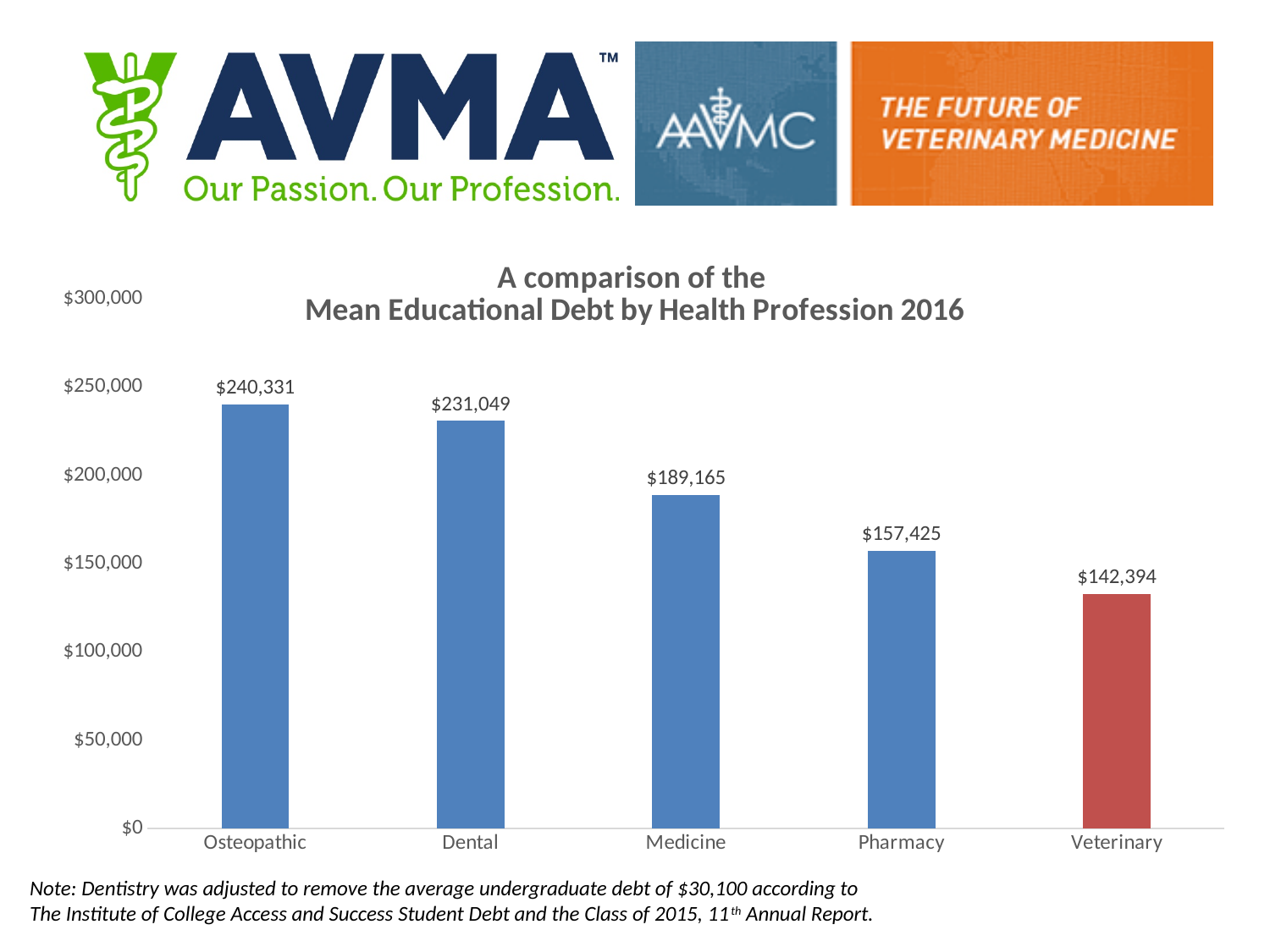
What is the difference in mean educational debt between Dental and Medicine? $41,884 Which bar in the chart is coloured red rather than blue? Veterinary Which has a higher mean educational debt, Medicine or Pharmacy? Medicine What is the difference in mean educational debt between Osteopathic and Veterinary? $97,937 What is the mean educational debt for Veterinary? $142,394 What is the mean educational debt for Osteopathic? $240,331 How many health professions are shown in the chart? 5 Which health profession has the highest mean educational debt? Osteopathic What kind of chart is shown on the slide? bar chart Is the value for Veterinary greater or less than $150,000? less What is the mean educational debt for Pharmacy? $157,425 Which health profession has the lowest mean educational debt? Veterinary